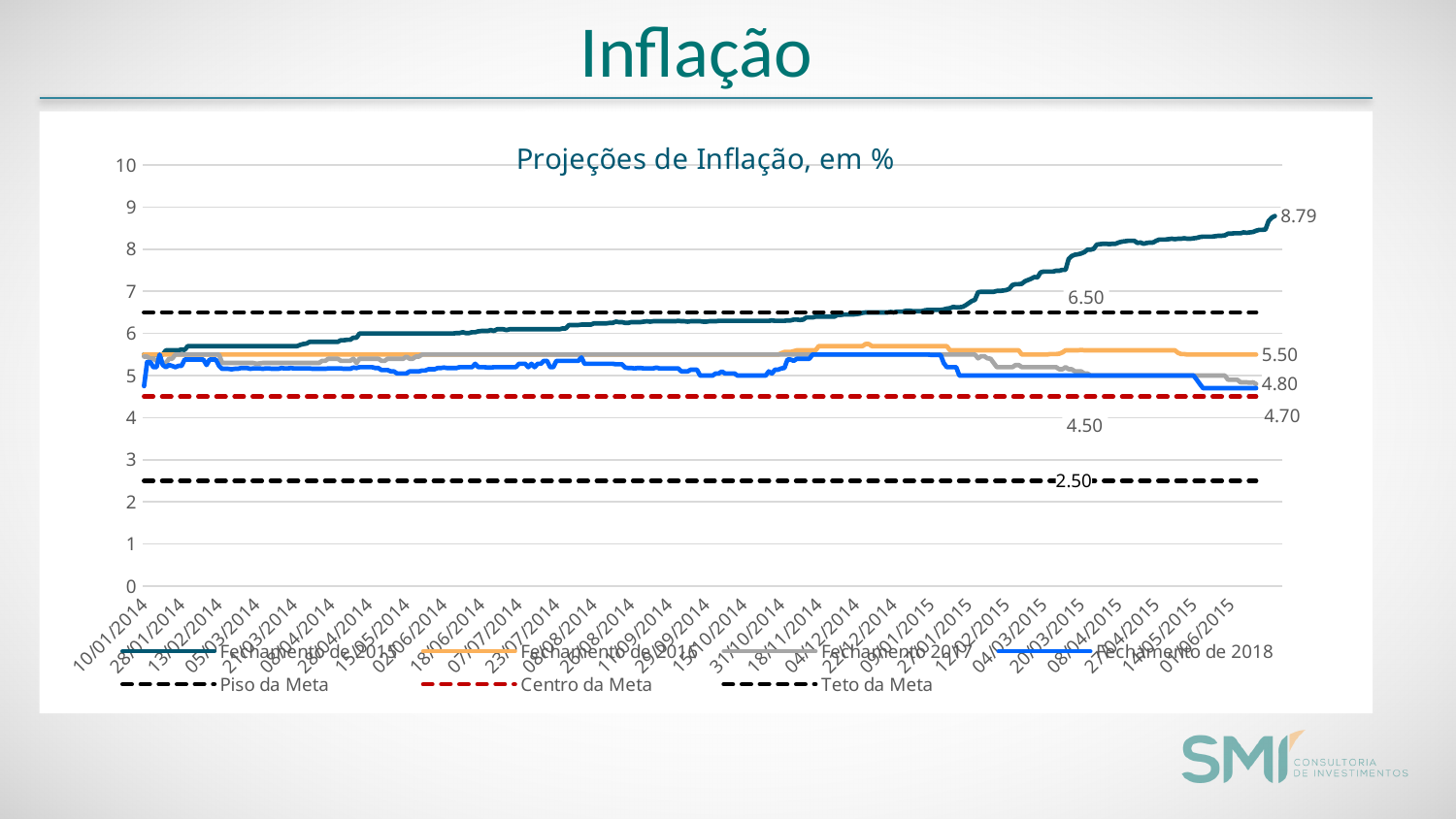
What is the difference between the Teto da Meta (6.50) and the Piso da Meta (2.50)? 4.00 Which series ends at the highest value at the right end of the chart? Fechamento de 2015 By how much does the final Fechamento de 2015 value (8.79) exceed the Teto da Meta (6.50)? 2.29 What is the title of the chart? Projeções de Inflação, em % What kind of chart is shown on the slide? line chart What value is labelled for the Centro da Meta line? 4.50 How many series does the legend list? 7 What is the last labelled value of the Fechamento de 2016 series? 5.50 Does the Fechamento de 2015 series rise or fall over the period shown? rises What value is labelled for the Teto da Meta line? 6.50 What value is labelled for the Piso da Meta line? 2.50 What is the last labelled value of the Fechamento de 2015 series? 8.79